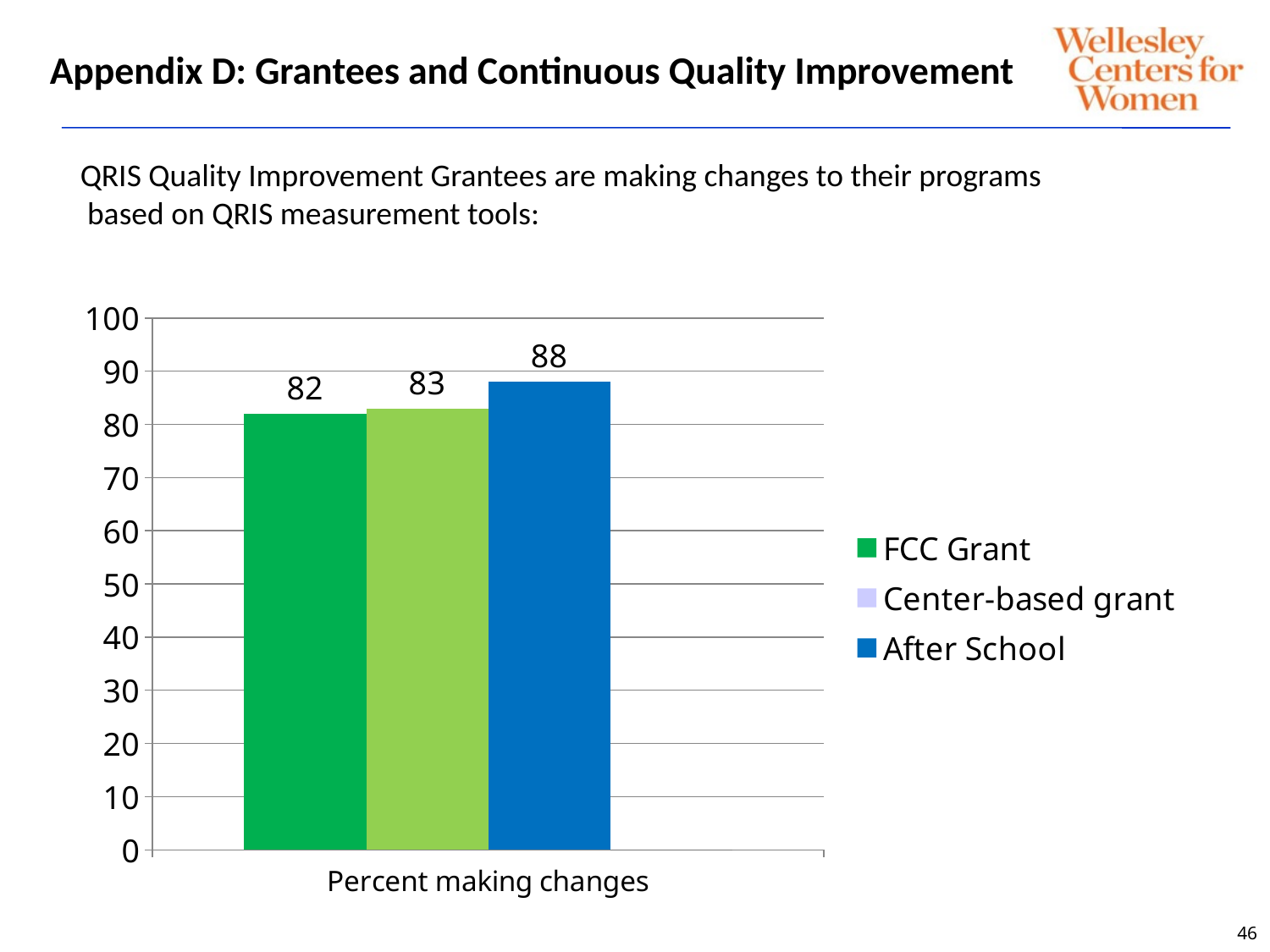
How many series does the legend list? 3 Which series has the highest value? After School What is the difference between the After School value and the FCC Grant value? 6 What is the value for After School? 88 Is the value for After School greater or less than 80? greater What is the value for Center-based grant? 83 What kind of chart is shown on the slide? Bar chart Which is larger, the value for After School or the value for FCC Grant? After School Which series has the lowest value? FCC Grant What is the difference between the After School value and the Center-based grant value? 5 What is the value for FCC Grant? 82 What is the label on the x axis of the chart? Percent making changes